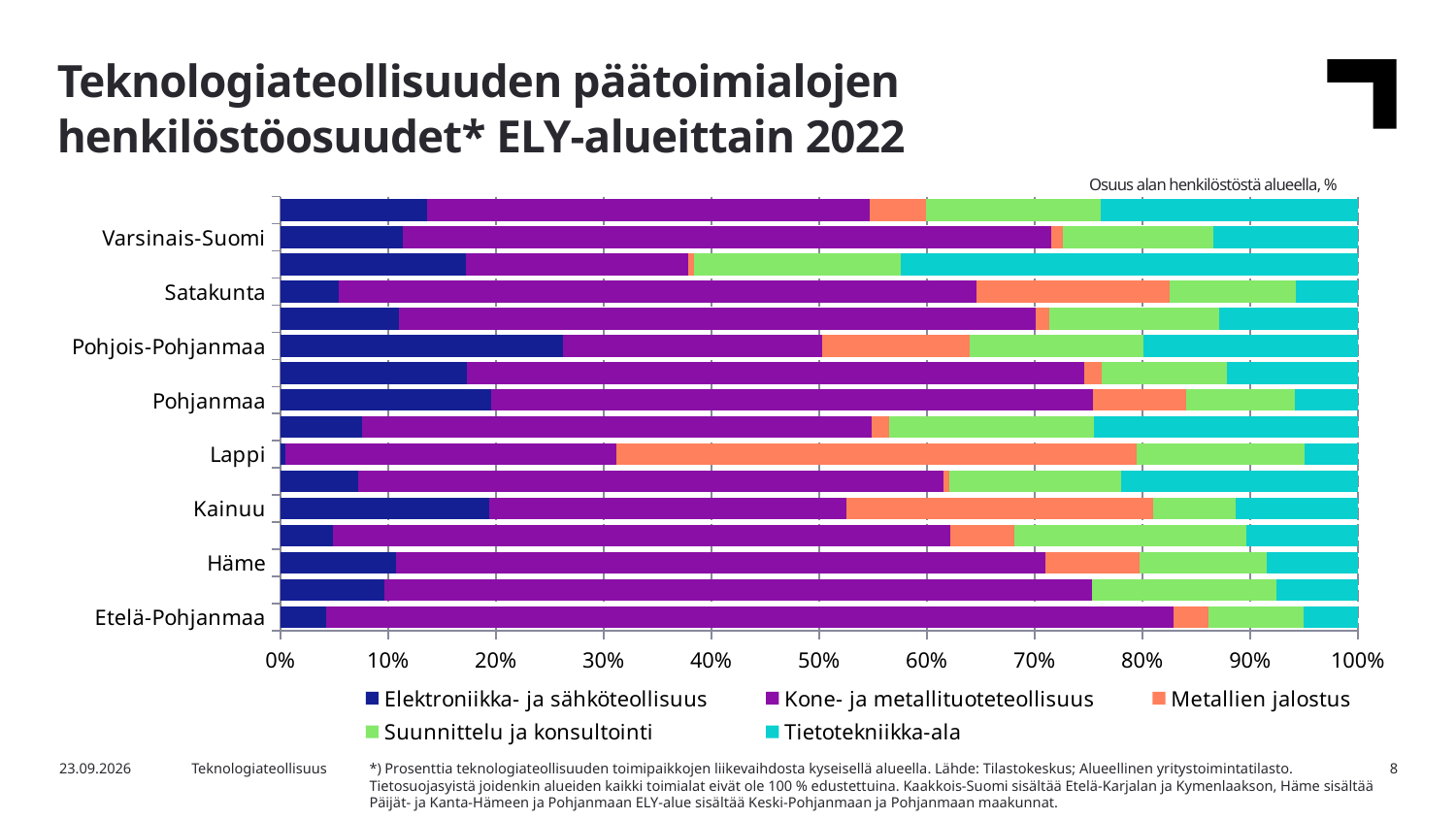
Among the labelled regions, which has the largest Metallien jalostus share? Lappi Is the Elektroniikka- ja sähköteollisuus share for Pohjois-Pohjanmaa greater or less than 20%? greater Is the Elektroniikka- ja sähköteollisuus share for Satakunta greater or less than 10%? less Which series is shown in orange in the legend? Metallien jalostus Which has the larger Elektroniikka- ja sähköteollisuus share, Pohjois-Pohjanmaa or Häme? Pohjois-Pohjanmaa Is the Metallien jalostus share for Lappi greater or less than 40%? greater What is the title of the chart on the slide? Teknologiateollisuuden päätoimialojen henkilöstöosuudet* ELY-alueittain 2022 How many series does the legend list? 5 Which has the larger Metallien jalostus share, Lappi or Varsinais-Suomi? Lappi What kind of chart is shown on the slide? Stacked bar chart